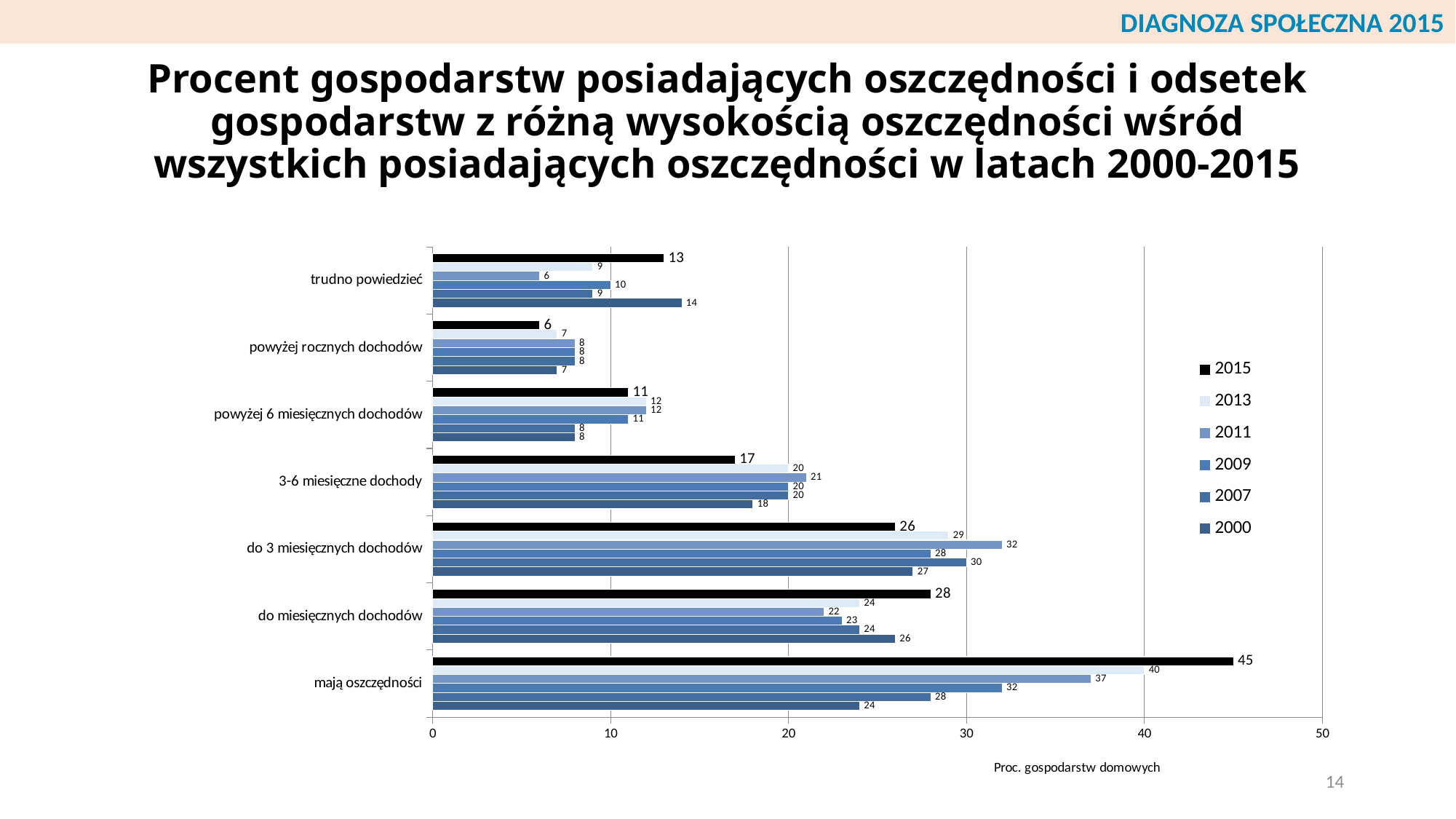
What kind of chart is shown on the slide? bar chart What is the 2000 value for "trudno powiedzieć"? 14 What is the difference between the 2015 and 2000 values for "mają oszczędności"? 21 Which is larger for "do miesięcznych dochodów": the 2015 value or the 2011 value? 2015 Which year has the lowest value for "trudno powiedzieć"? 2011 How many series does the legend list? 6 What is the label of the horizontal axis? Proc. gospodarstw domowych Does the value for "mają oszczędności" rise or fall from 2000 to 2015? rise What is the 2015 value for "mają oszczędności"? 45 Which year has the highest value for "mają oszczędności"? 2015 What is the 2011 value for "do 3 miesięcznych dochodów"? 32 How many categories are shown on the vertical axis? 7